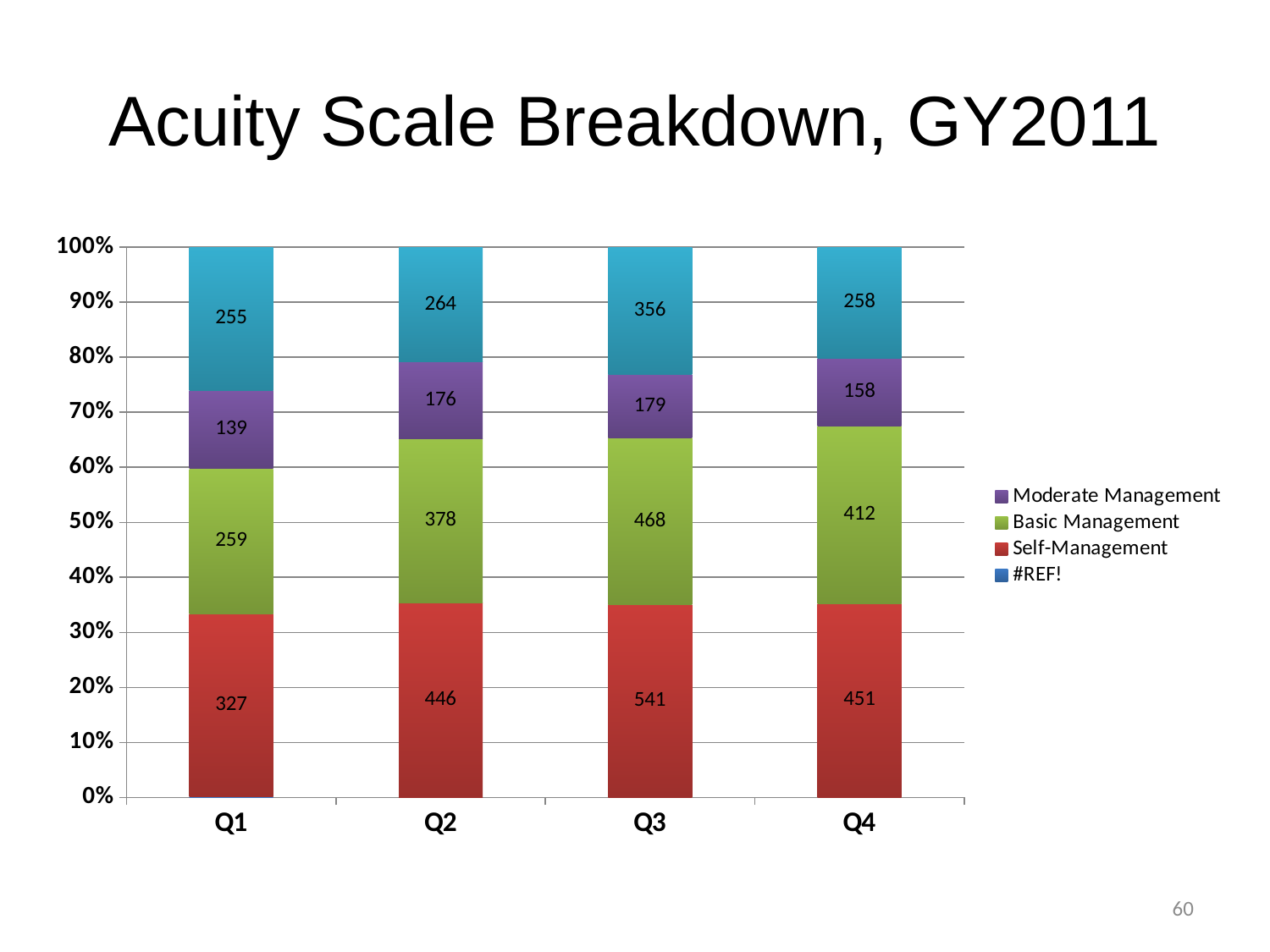
Which quarter has the larger Basic Management value, Q2 or Q4? Q4 How many entries does the legend list? 4 Does the Basic Management value rise or fall from Q1 to Q3? Rise What kind of chart is shown on the slide? Stacked bar chart What is the Basic Management value for Q2? 378 What is the Self-Management value for Q3? 541 What is the Moderate Management value for Q4? 158 Is the Self-Management share of the Q1 bar greater or less than 40%? less How many quarters are shown on the x axis? 4 What is the difference between the Self-Management values for Q3 and Q1? 214 Which quarter has the lowest Moderate Management value? Q1 Which quarter has the highest Self-Management value? Q3